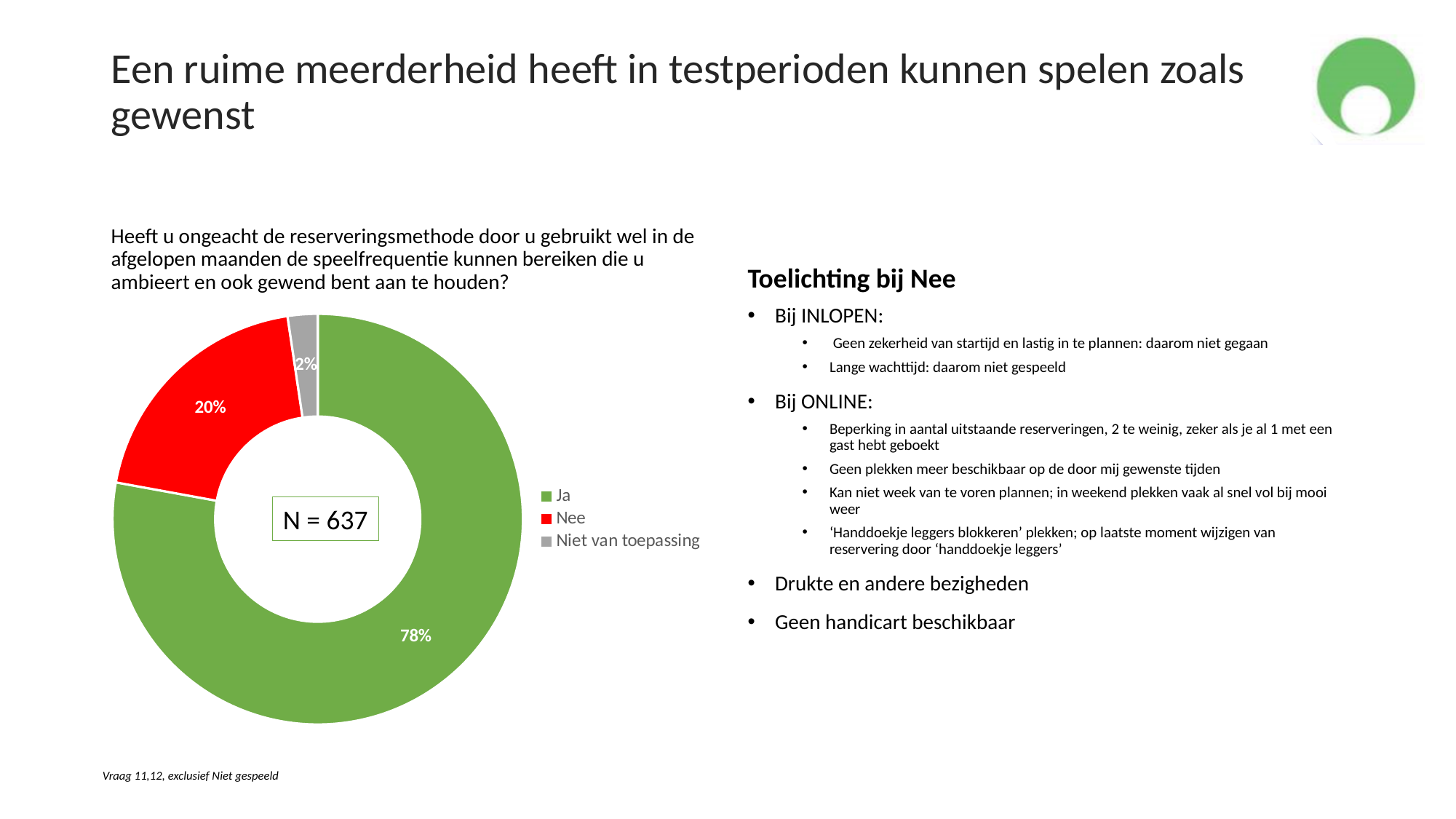
What colour represents the "Nee" category in the chart? Red Which category has the largest share of the chart? Ja What is the combined share of "Nee" and "Niet van toepassing"? 22% What is the difference in percentage points between "Ja" and "Nee"? 58 What percentage of respondents answered "Niet van toepassing"? 2% How many categories are shown in the chart? 3 What percentage of respondents answered "Ja"? 78% What is the sample size (N) shown in the centre of the chart? N = 637 What kind of chart is shown on the slide? Doughnut (pie) chart Which category has the smallest share of the chart? Niet van toepassing Which is larger, the share for "Nee" or the share for "Niet van toepassing"? Nee What percentage of respondents answered "Nee"? 20%